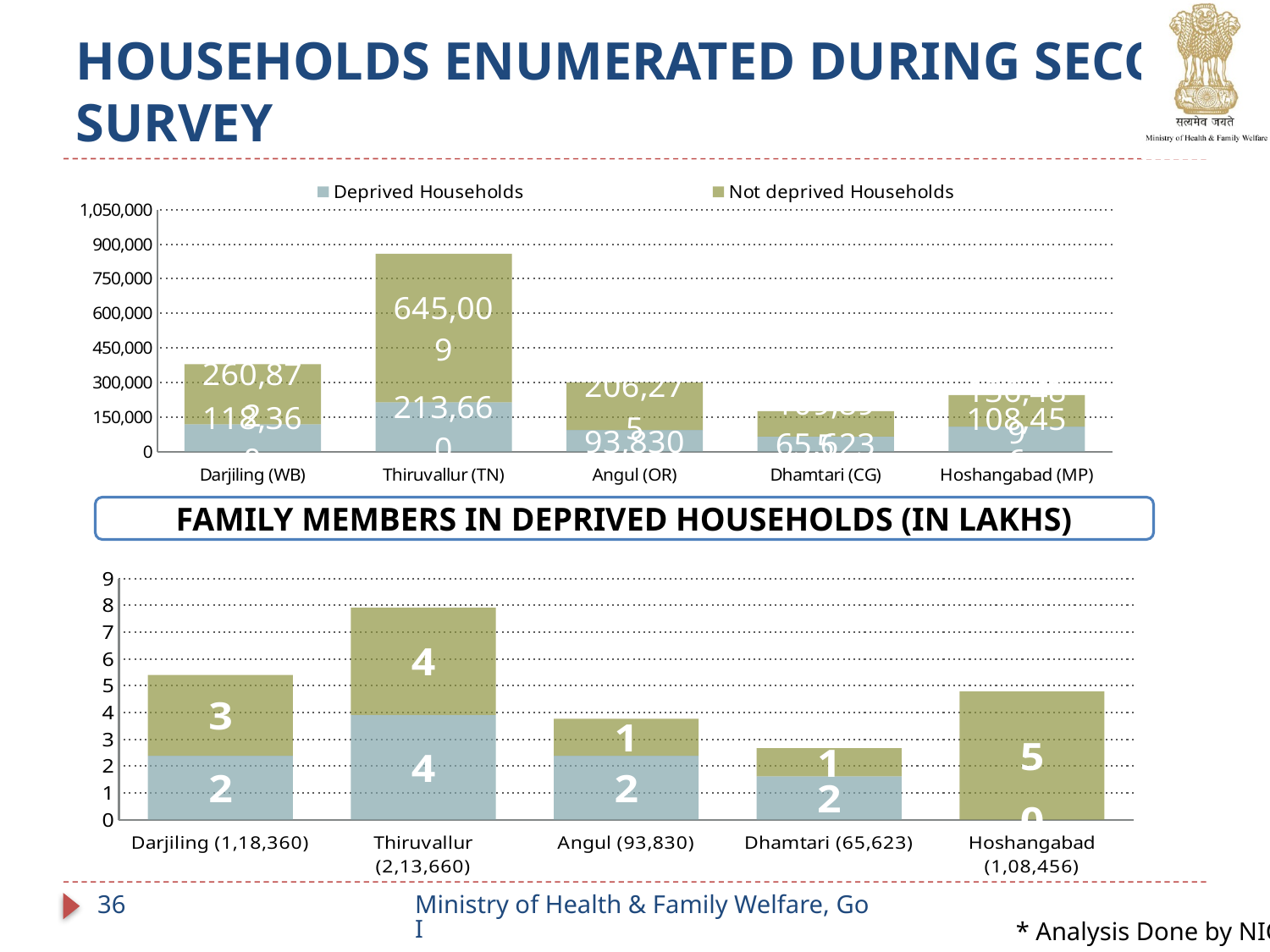
In the top chart, what is the value of Not deprived Households for Thiruvallur (TN)? 645,009 How many districts are shown on the x axis of the top chart? 5 In the top chart, what is the value of Deprived Households for Dhamtari (CG)? 65,623 In the top chart, what is the value of Deprived Households for Thiruvallur (TN)? 213,660 In the top chart, what is the difference between the Deprived Households values for Thiruvallur (TN) and Angul (OR)? 119,830 In the top chart, what is the value of Deprived Households for Angul (OR)? 93,830 In the top chart, what is the total height of the stacked bar for Thiruvallur (TN)? 858,669 How many series does the legend of the top chart list? 2 In the top chart, is the total stacked bar for Hoshangabad (MP) greater or less than 300,000? less In the bottom chart (Family Members in Deprived Households), is the stacked bar for Thiruvallur greater or less than 7? greater In the top chart, which district has the tallest stacked bar? Thiruvallur (TN) What kind of chart is the top chart on the slide? Stacked bar chart